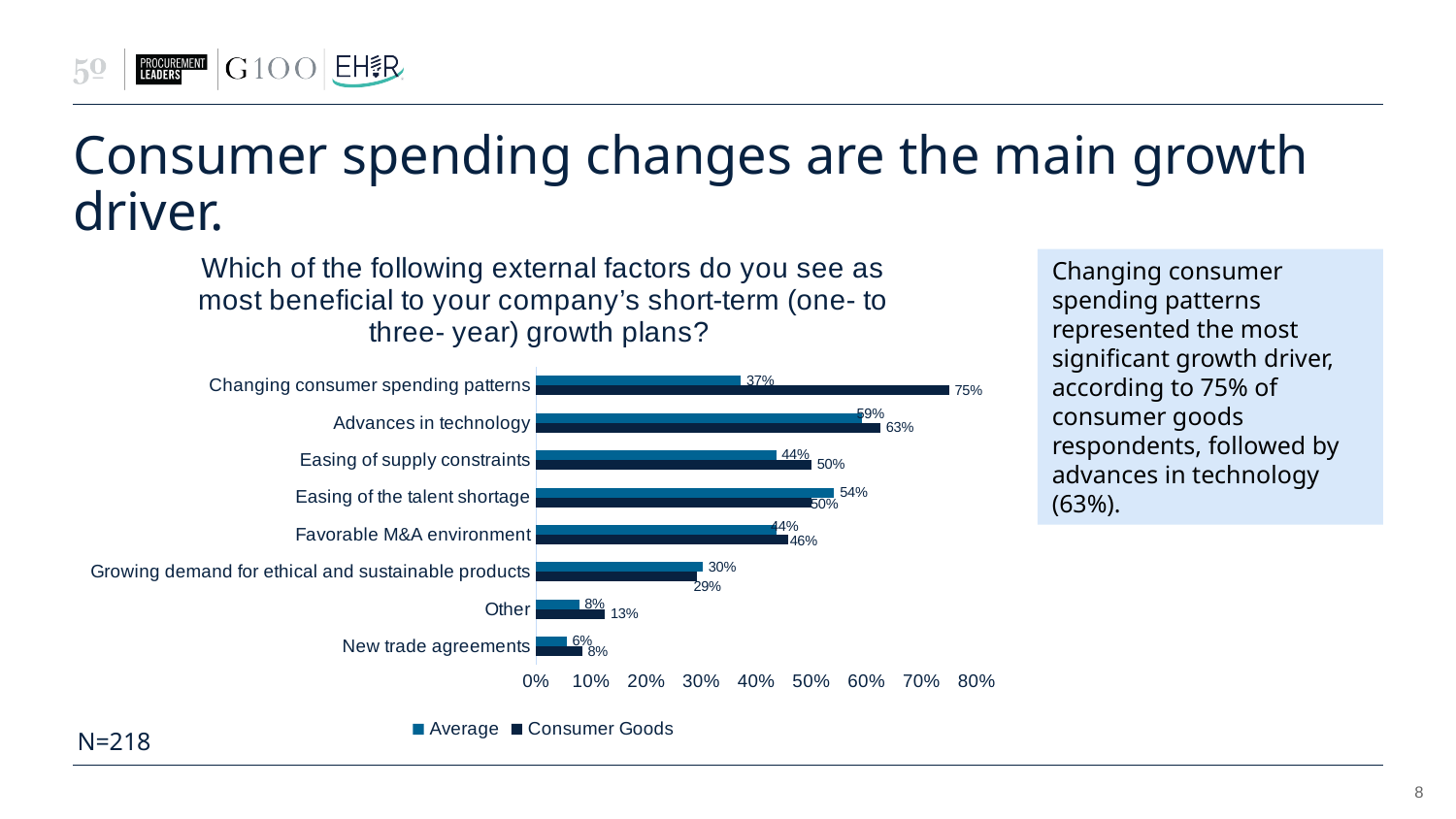
What is the Consumer Goods value for Other? 13% What is the Average value for Advances in technology? 59% What is the difference between the Consumer Goods and Average values for Changing consumer spending patterns? 38% Which is larger for Easing of the talent shortage, the Average value or the Consumer Goods value? Average Which category has the highest Average value? Advances in technology Which category has the lowest Average value? New trade agreements What is the Consumer Goods value for Changing consumer spending patterns? 75% What kind of chart is shown on the slide? Bar chart Which category has the highest Consumer Goods value? Changing consumer spending patterns How many categories are shown on the chart? 8 How many series does the legend list? 2 What are the two series named in the legend? Average and Consumer Goods